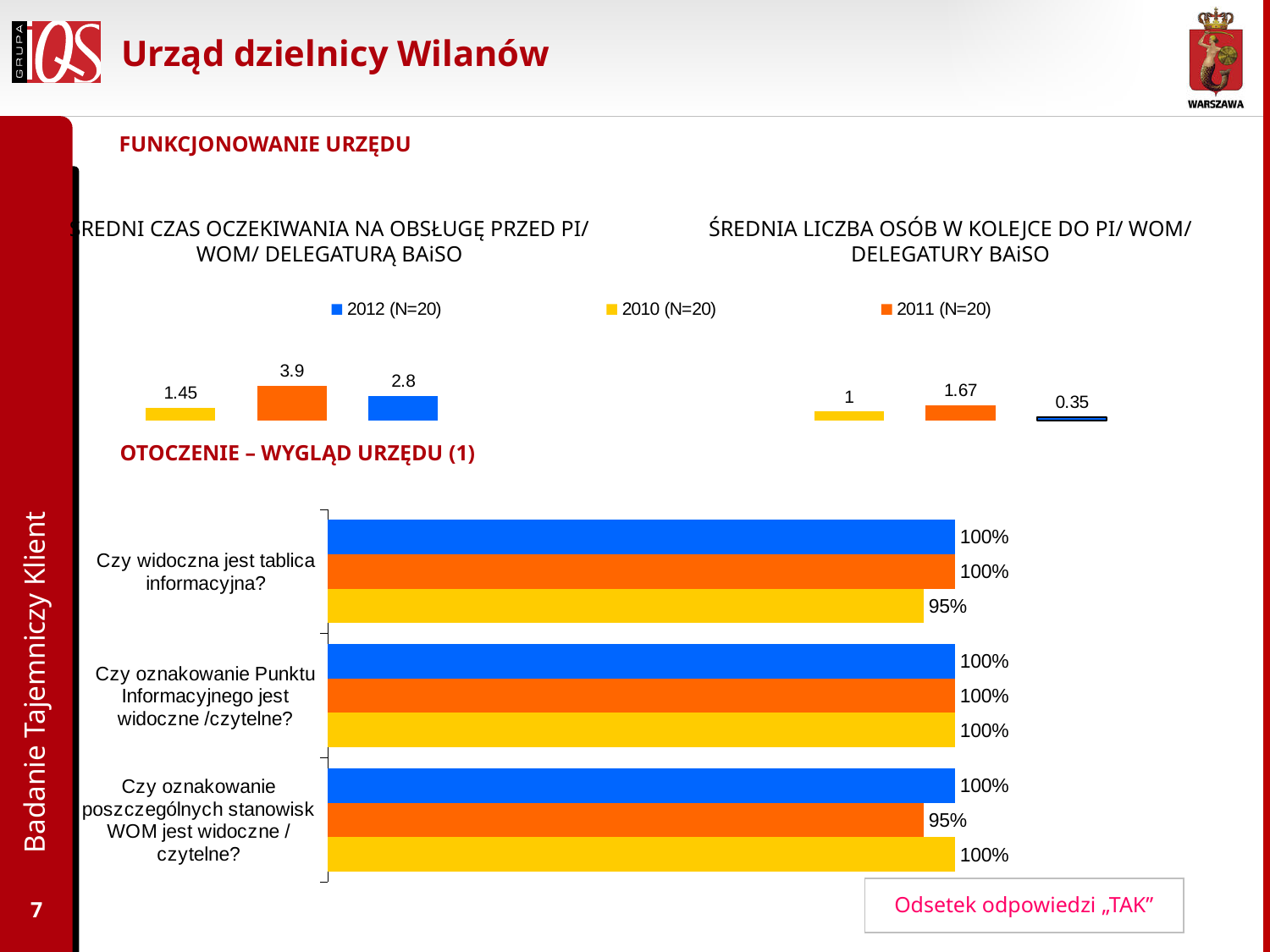
In the chart titled 'ŚREDNIA LICZBA OSÓB W KOLEJCE DO PI/ WOM/ DELEGATURY BAiSO', which year has the highest value? 2011 (N=20) In the bottom chart (OTOCZENIE – WYGLĄD URZĘDU), what is the 2011 value for 'Czy oznakowanie poszczególnych stanowisk WOM jest widoczne / czytelne?'? 95% In the chart titled 'ŚREDNIA LICZBA OSÓB W KOLEJCE DO PI/ WOM/ DELEGATURY BAiSO', what is the value for 2012 (N=20)? 0.35 In the chart titled 'ŚREDNIA LICZBA OSÓB W KOLEJCE DO PI/ WOM/ DELEGATURY BAiSO', which is larger: the value for 2010 or the value for 2012? 2010 In the chart titled 'ŚREDNI CZAS OCZEKIWANIA NA OBSŁUGĘ PRZED PI/ WOM/ DELEGATURĄ BAiSO', what is the difference between the 2011 and 2012 values? 1.1 In the chart titled 'ŚREDNI CZAS OCZEKIWANIA NA OBSŁUGĘ PRZED PI/ WOM/ DELEGATURĄ BAiSO', what is the value for 2011 (N=20)? 3.9 In the chart titled 'ŚREDNI CZAS OCZEKIWANIA NA OBSŁUGĘ PRZED PI/ WOM/ DELEGATURĄ BAiSO', which year has the lowest value? 2010 (N=20) In the bottom chart (OTOCZENIE – WYGLĄD URZĘDU), how many question categories are shown on the vertical axis? 3 In the bottom chart (OTOCZENIE – WYGLĄD URZĘDU), what is the 2010 value for 'Czy widoczna jest tablica informacyjna?'? 95% What kind of chart is the bottom chart (OTOCZENIE – WYGLĄD URZĘDU)? Bar chart In the bottom chart (OTOCZENIE – WYGLĄD URZĘDU), what is the difference between the 2012 and 2010 values for 'Czy widoczna jest tablica informacyjna?'? 5% How many series does the legend above the top charts list? 3